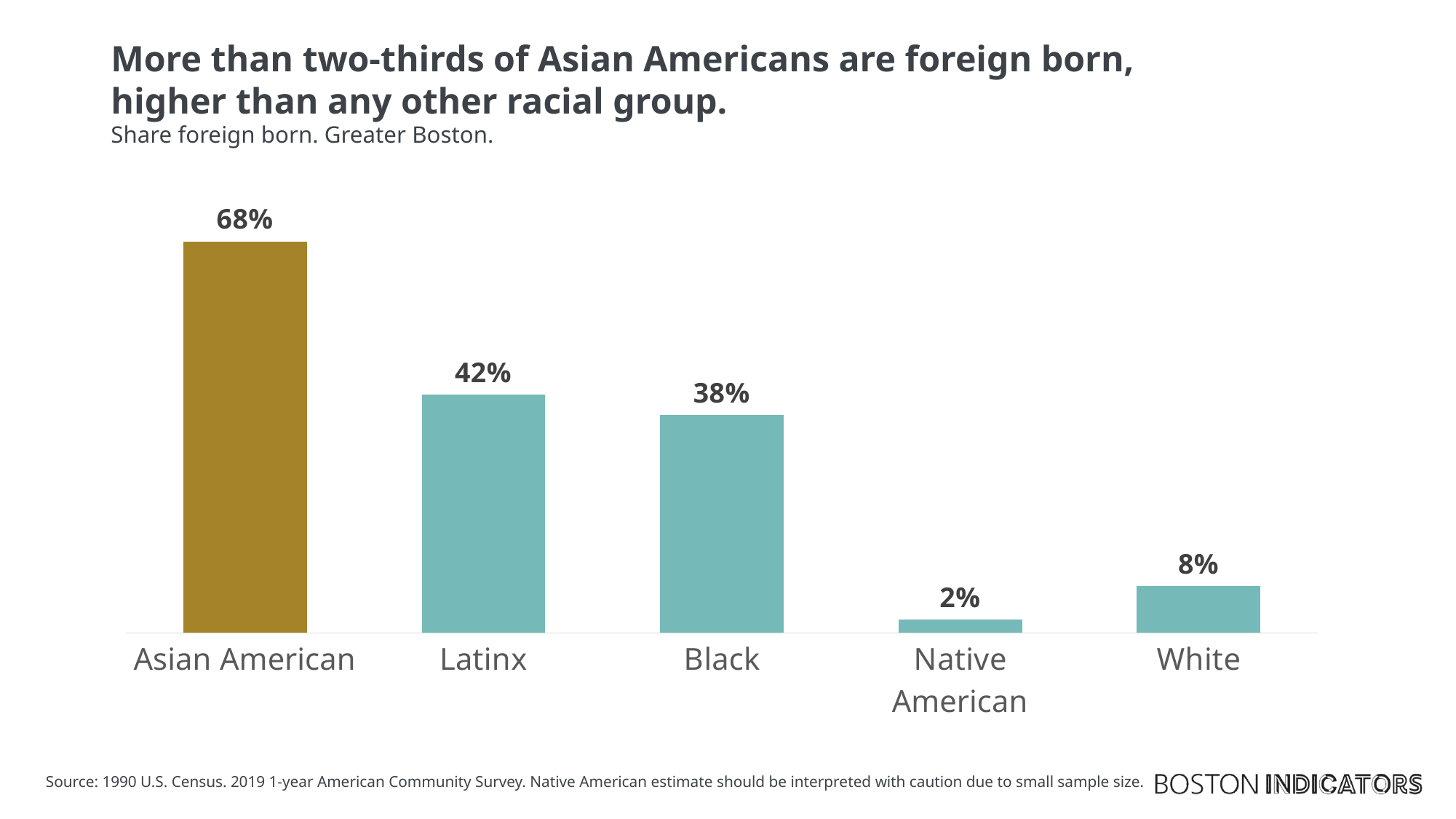
What is the difference in share foreign born between Asian American and Latinx? 26% What is the share foreign born for Asian American? 68% What is the share foreign born for Native American? 2% How many racial groups are shown in the chart? 5 Which has a larger share foreign born, White or Native American? White What is the share foreign born for Latinx? 42% What is the share foreign born for Black? 38% What is the difference in share foreign born between Latinx and Black? 4% What is the share foreign born for White? 8% What kind of chart is shown on the slide? Bar chart Which racial group has the lowest share foreign born? Native American Which racial group has the highest share foreign born? Asian American